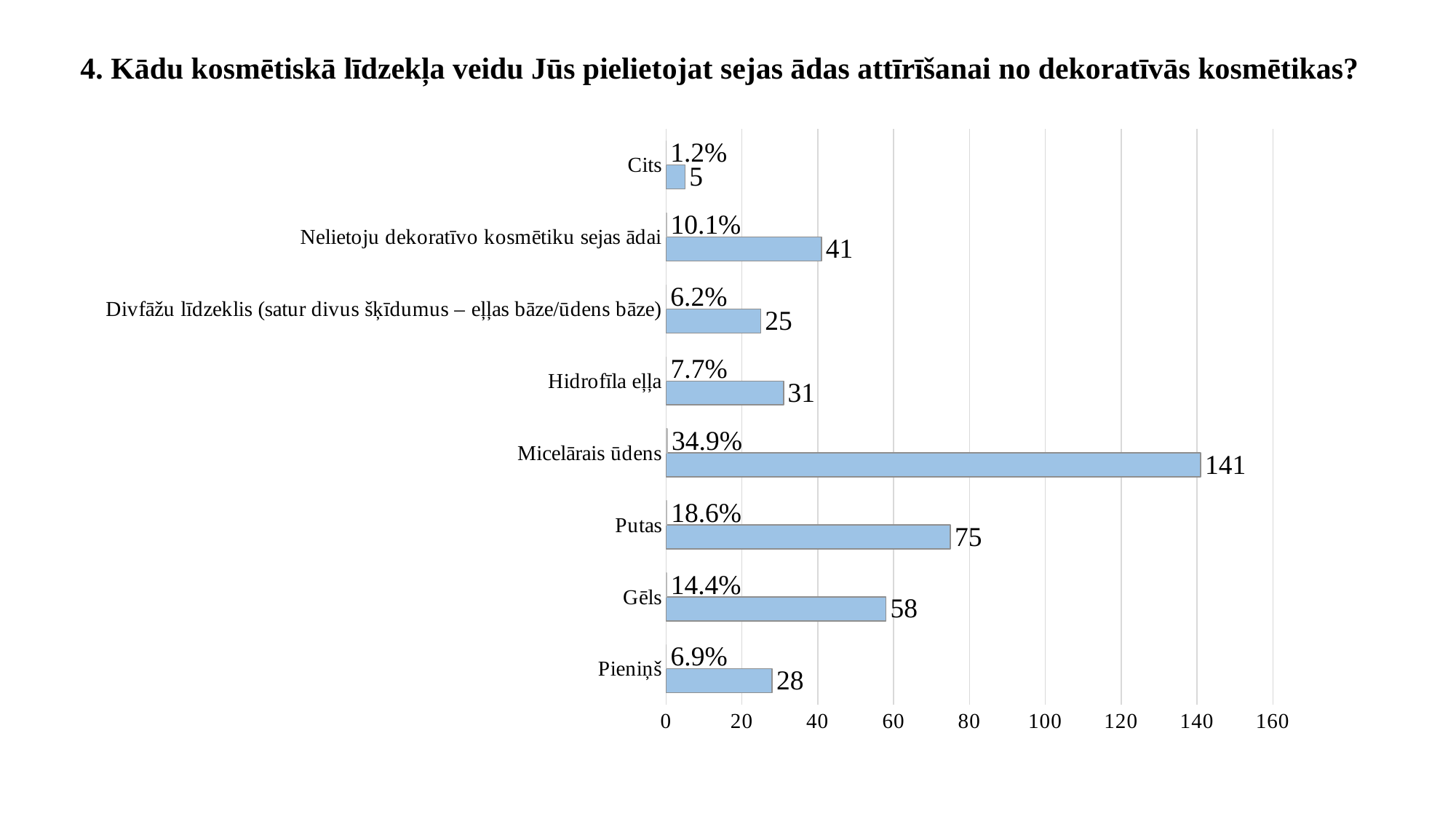
Which category has the lowest value? Cits Which category has the highest value? Micelārais ūdens Which has a larger count, Gēls or Nelietoju dekoratīvo kosmētiku sejas ādai? Gēls What percentage is shown for Putas? 18.6% What is the difference between the count for Micelārais ūdens and the count for Putas? 66 Is the value for Pieniņš greater or less than 40? less What is the count value for Gēls? 58 What is the count value for Divfāžu līdzeklis (satur divus šķīdumus – eļļas bāze/ūdens bāze)? 25 What kind of chart is shown on the slide? bar chart What percentage is shown for Hidrofīla eļļa? 7.7% How many categories are shown in the chart? 8 What is the count value for Micelārais ūdens? 141